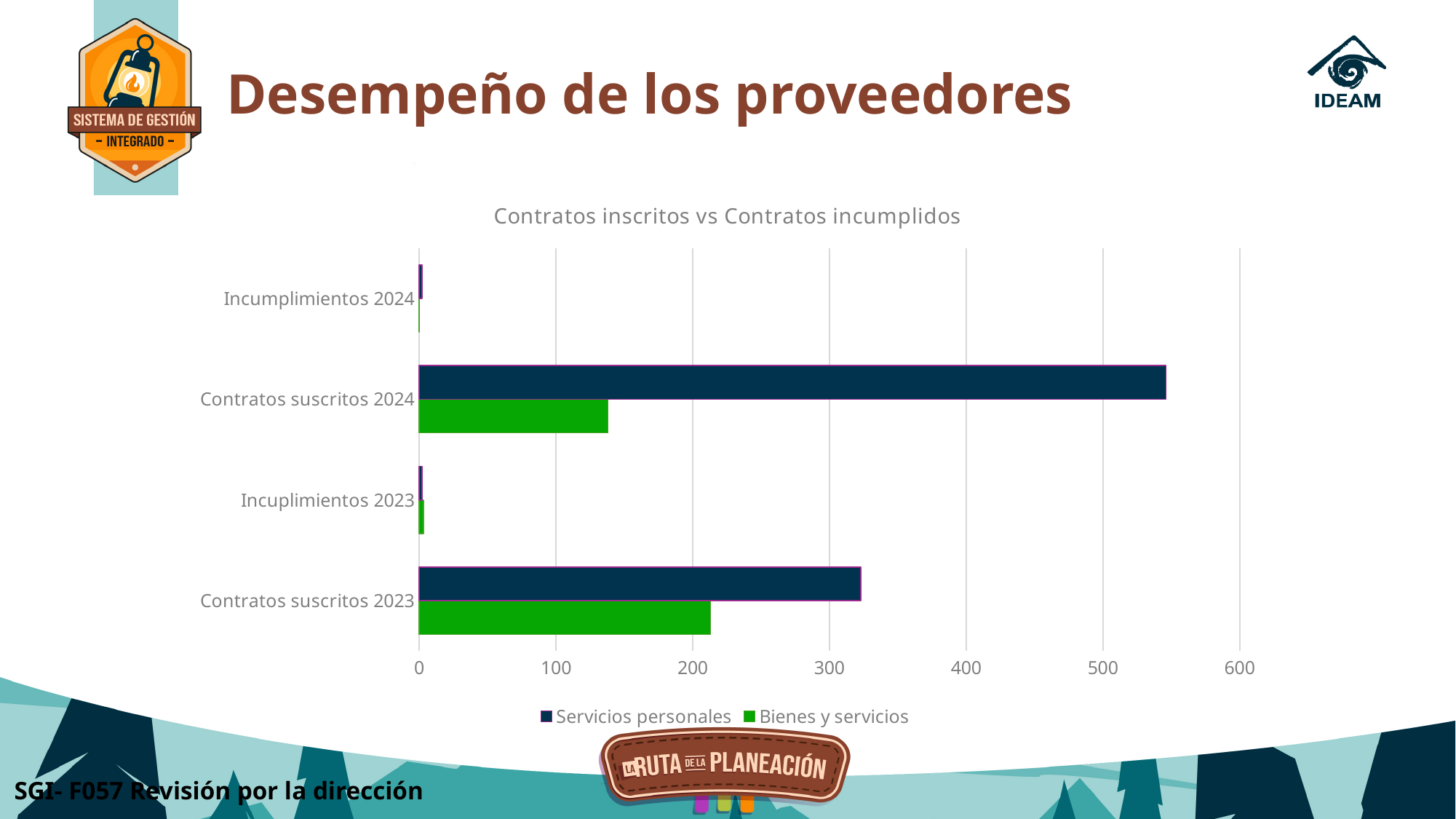
Is the value for Servicios personales in Contratos suscritos 2024 greater or less than 500? greater Which category has the highest value for Servicios personales? Contratos suscritos 2024 How many categories are shown on the vertical axis of the chart? 4 What is the title of the chart? Contratos inscritos vs Contratos incumplidos Is the value for Bienes y servicios in Contratos suscritos 2023 greater or less than 300? less Which series is shown in green in the chart? Bienes y servicios Is the value for Servicios personales in Contratos suscritos 2023 greater or less than 300? greater What kind of chart is shown on the slide? bar chart For Contratos suscritos 2023, which series has the larger value: Servicios personales or Bienes y servicios? Servicios personales How many series does the legend list? 2 Which category has the highest value for Bienes y servicios? Contratos suscritos 2023